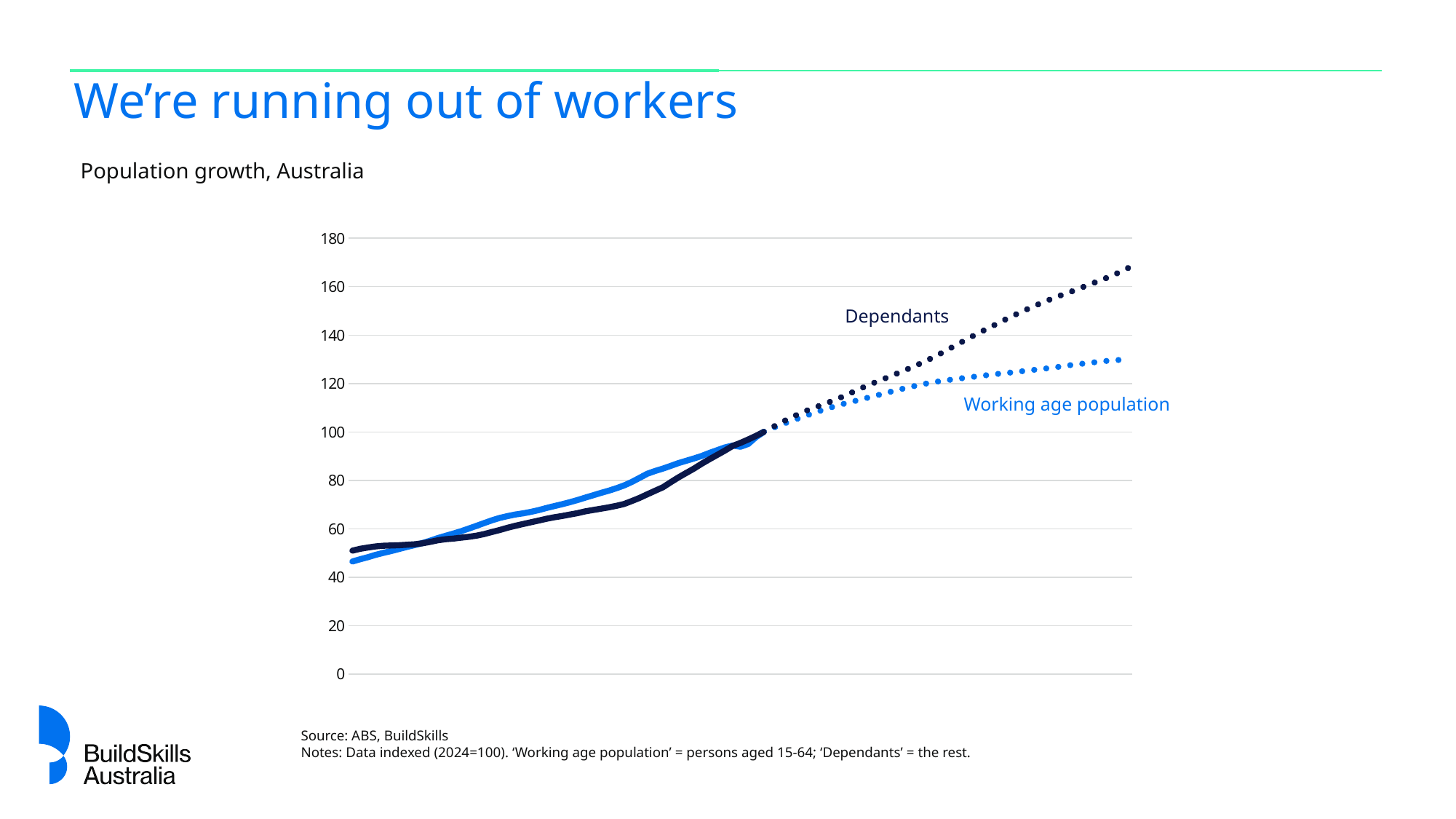
Which series reaches the highest value on the chart? Dependants Is the starting value for Working age population greater or less than 60? less What kind of chart is shown on the slide? line chart Is the final value for Dependants greater or less than 160? greater Do the values for Dependants rise or fall from left to right? rise How many series are plotted on the chart? 2 According to the notes, what index value do both series take in 2024? 100 What is the title of the chart? Population growth, Australia Which series is drawn in dark navy? Dependants At the right-hand end of the chart, which series is higher: Dependants or Working age population? Dependants Is the final value for Working age population greater or less than 140? less Do the values for Working age population rise or fall from left to right? rise